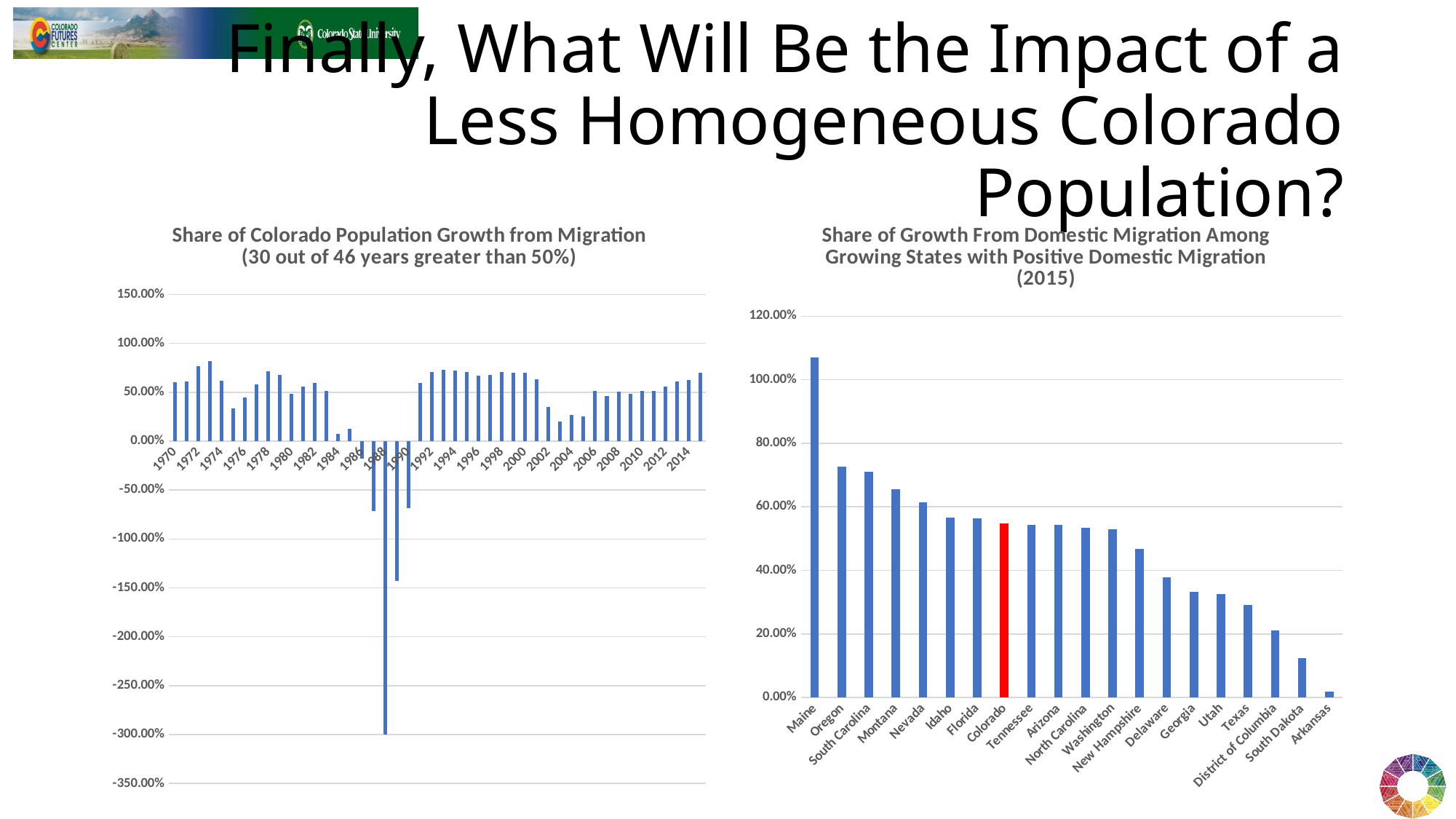
In the left-hand chart (Share of Colorado Population Growth from Migration), is the value for 1989 greater or less than -250.00%? greater In the right-hand chart (Share of Growth From Domestic Migration, 2015), which state's bar is coloured red? Colorado In the right-hand chart (Share of Growth From Domestic Migration, 2015), is the value for Maine greater or less than 100.00%? greater In the right-hand chart (Share of Growth From Domestic Migration, 2015), which has the larger value, Oregon or Texas? Oregon What kind of chart is the left-hand chart, 'Share of Colorado Population Growth from Migration'? bar chart In the right-hand chart (Share of Growth From Domestic Migration, 2015), which state has the highest value? Maine In the right-hand chart (Share of Growth From Domestic Migration, 2015), is the value for Colorado greater or less than 40.00%? greater What kind of chart is the right-hand chart, 'Share of Growth From Domestic Migration Among Growing States with Positive Domestic Migration (2015)'? bar chart In the right-hand chart (Share of Growth From Domestic Migration, 2015), which state has the lowest value? Arkansas How many states are shown in the right-hand chart (Share of Growth From Domestic Migration, 2015)? 20 In the right-hand chart (Share of Growth From Domestic Migration, 2015), do the values rise or fall from left to right across the states? fall